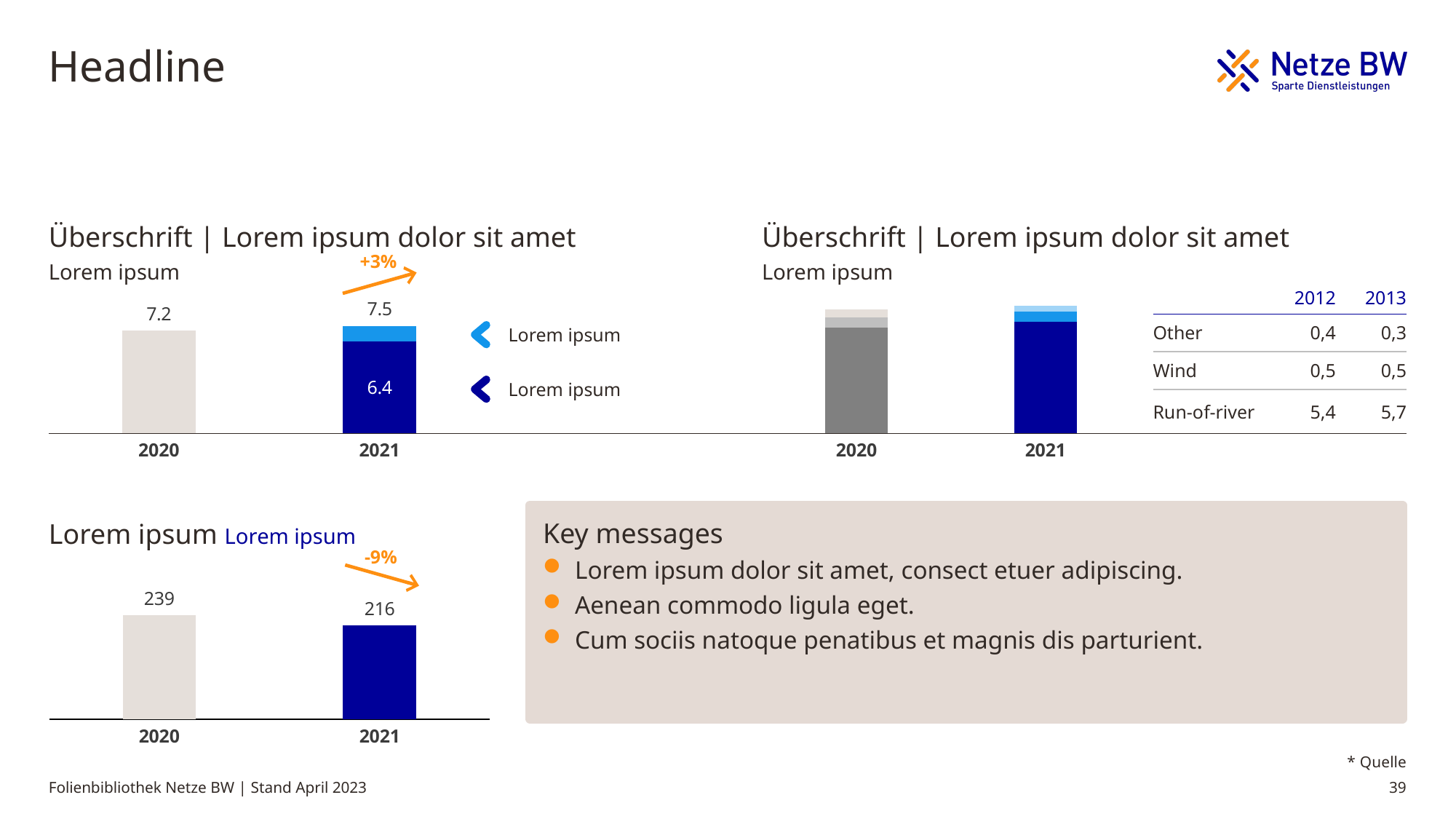
What kind of chart is the top-right chart? bar chart In the top-left chart, what is the value for 2020? 7.2 In the bottom-left chart, what is the value for 2020? 239 In the top-left chart, what is the total value for 2021? 7.5 In the top-left chart, what is the value of the dark blue segment of the 2021 bar? 6.4 In the top-left chart, which year has the higher value, 2020 or 2021? 2021 In the bottom-left chart, do the values rise or fall from 2020 to 2021? fall In the bottom-left chart, which year has the lowest value? 2021 In the bottom-left chart, what percentage change is shown between 2020 and 2021? -9% In the bottom-left chart, what is the difference between the 2020 and 2021 values? 23 In the bottom-left chart, what is the value for 2021? 216 In the top-left chart, what percentage change is shown between 2020 and 2021? +3%